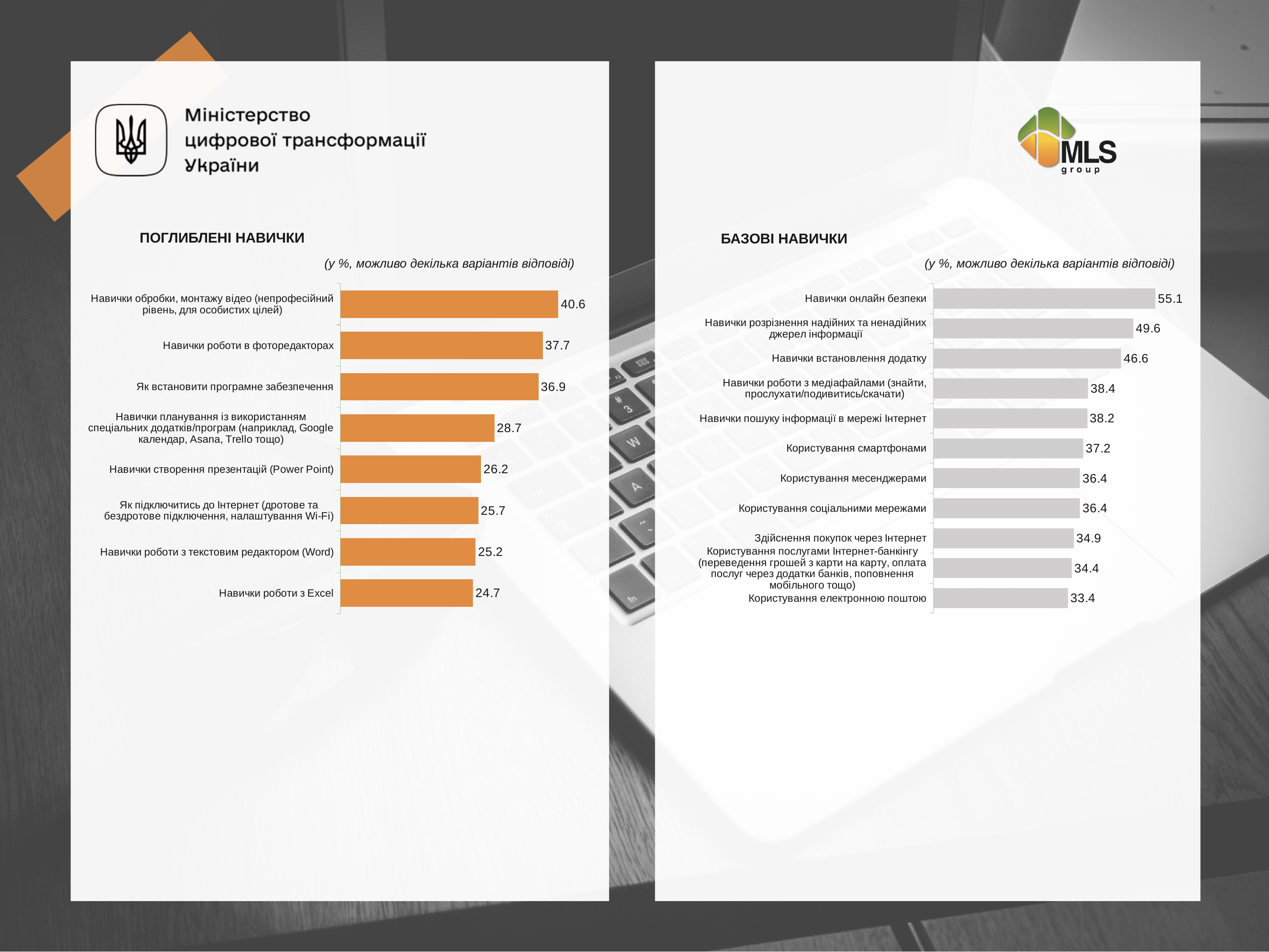
In the 'БАЗОВІ НАВИЧКИ' chart, what is the difference between 'Навички онлайн безпеки' and 'Навички розрізнення надійних та ненадійних джерел інформації'? 5.5 In the 'ПОГЛИБЛЕНІ НАВИЧКИ' chart, which category has the highest value? Навички обробки, монтажу відео (непрофесійний рівень, для особистих цілей) In the 'БАЗОВІ НАВИЧКИ' chart, what is the value for 'Навички встановлення додатку'? 46.6 In the 'ПОГЛИБЛЕНІ НАВИЧКИ' chart, what is the difference between 'Навички роботи в фоторедакторах' and 'Як встановити програмне забезпечення'? 0.8 What colour are the bars in the 'ПОГЛИБЛЕНІ НАВИЧКИ' chart? orange How many categories are shown in the 'ПОГЛИБЛЕНІ НАВИЧКИ' chart? 8 In the 'БАЗОВІ НАВИЧКИ' chart, which category has the lowest value? Користування електронною поштою What type of chart is the 'ПОГЛИБЛЕНІ НАВИЧКИ' chart? bar chart In the 'БАЗОВІ НАВИЧКИ' chart, what is the value for 'Користування соціальними мережами'? 36.4 In the 'БАЗОВІ НАВИЧКИ' chart, which is larger: 'Користування смартфонами' or 'Здійснення покупок через Інтернет'? Користування смартфонами How many categories are shown in the 'БАЗОВІ НАВИЧКИ' chart? 11 In the 'ПОГЛИБЛЕНІ НАВИЧКИ' chart, what is the value for 'Навички роботи з Excel'? 24.7